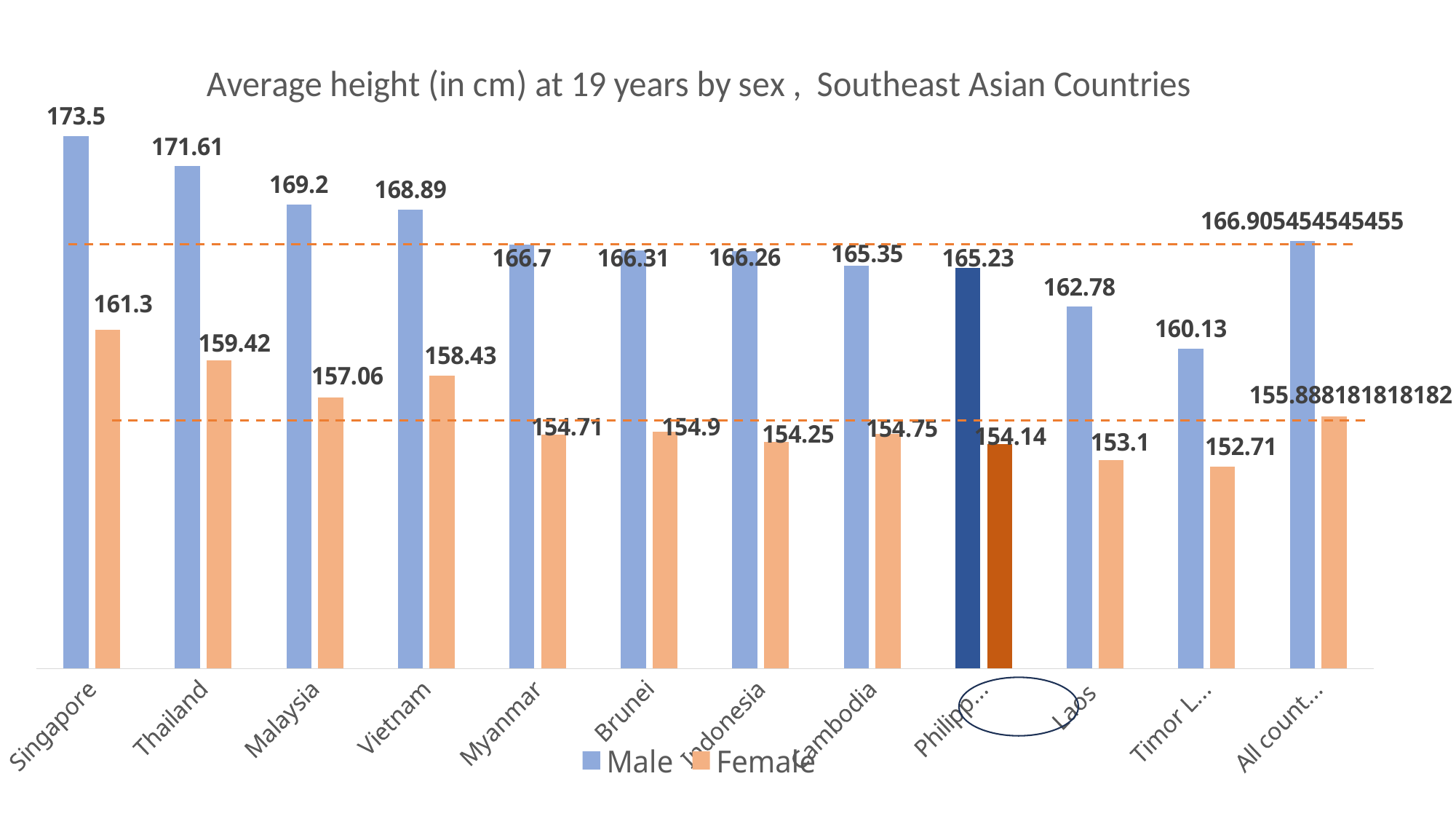
Which country has the highest Female value? Singapore Do the Male values rise or fall along the x axis from Singapore to Laos? Fall What is the Male value for Singapore? 173.5 What kind of chart is shown on the slide? Bar chart How many categories are shown on the x axis? 12 Which has the larger Female value, Vietnam or Malaysia? Vietnam How many series does the legend list? 2 What is the Female value for Thailand? 159.42 What is the Male value for Cambodia? 165.35 What is the difference between the Male values for Thailand and Malaysia? 2.41 What is the difference between the Male and Female values for Singapore? 12.2 Which country has the highest Male value? Singapore